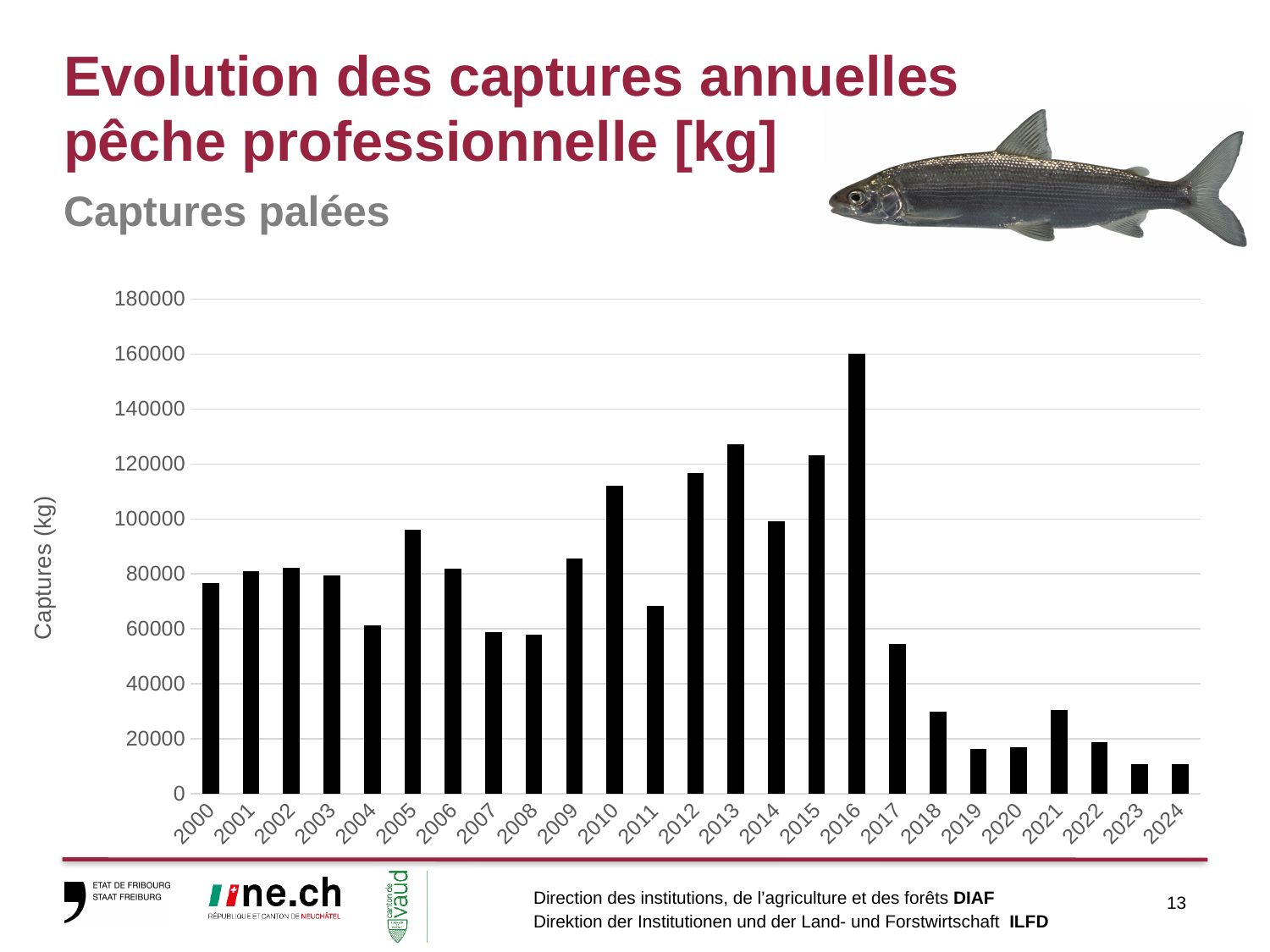
Is the value for 2019 greater or less than 20000? less Is the value for 2013 greater or less than 120000? greater Is the value for 2017 greater or less than 60000? less What is the label on the vertical axis of the chart? Captures (kg) How many years (bars) are plotted on the chart? 25 Which year has the highest captures on the chart? 2016 Which year has the larger value, 2013 or 2014? 2013 What kind of chart is shown on the slide? bar chart Do the values generally rise or fall from 2016 to 2024? fall Which year has the larger value, 2016 or 2017? 2016